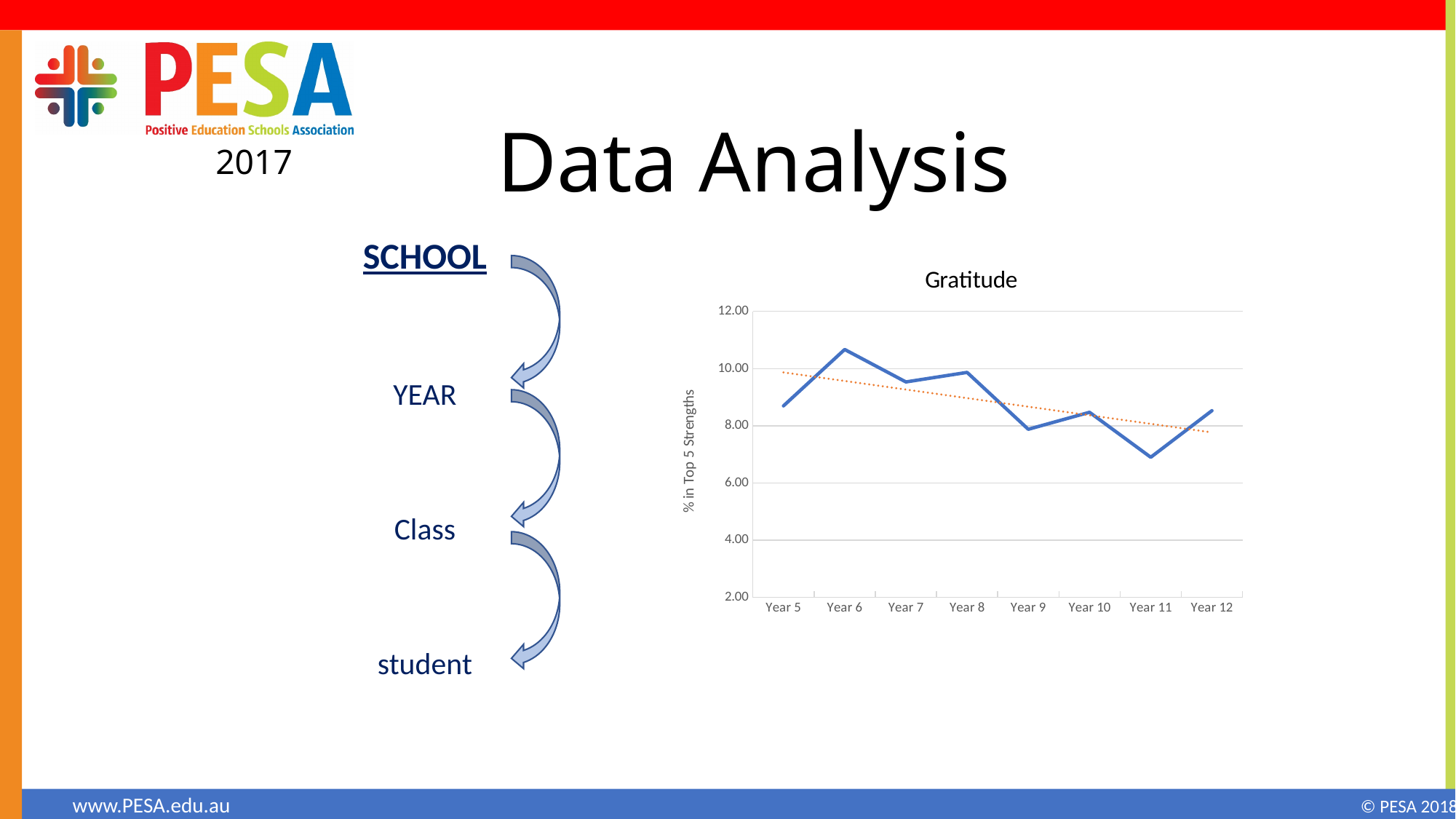
What is the label on the vertical axis of the chart? % in Top 5 Strengths Does the dotted trend line in the Gratitude chart rise or fall from Year 5 to Year 12? fall Is the value for Year 6 greater or less than 10.00? greater What kind of chart is shown on the slide? line chart What is the title of the chart? Gratitude Is the value for Year 8 greater or less than 10.00? less Which is larger, the value for Year 8 or the value for Year 9? Year 8 Is the value for Year 11 greater or less than 8.00? less How many year groups are plotted along the x axis of the chart? 8 Which year group has the lowest value in the Gratitude chart? Year 11 Which year group has the highest value in the Gratitude chart? Year 6